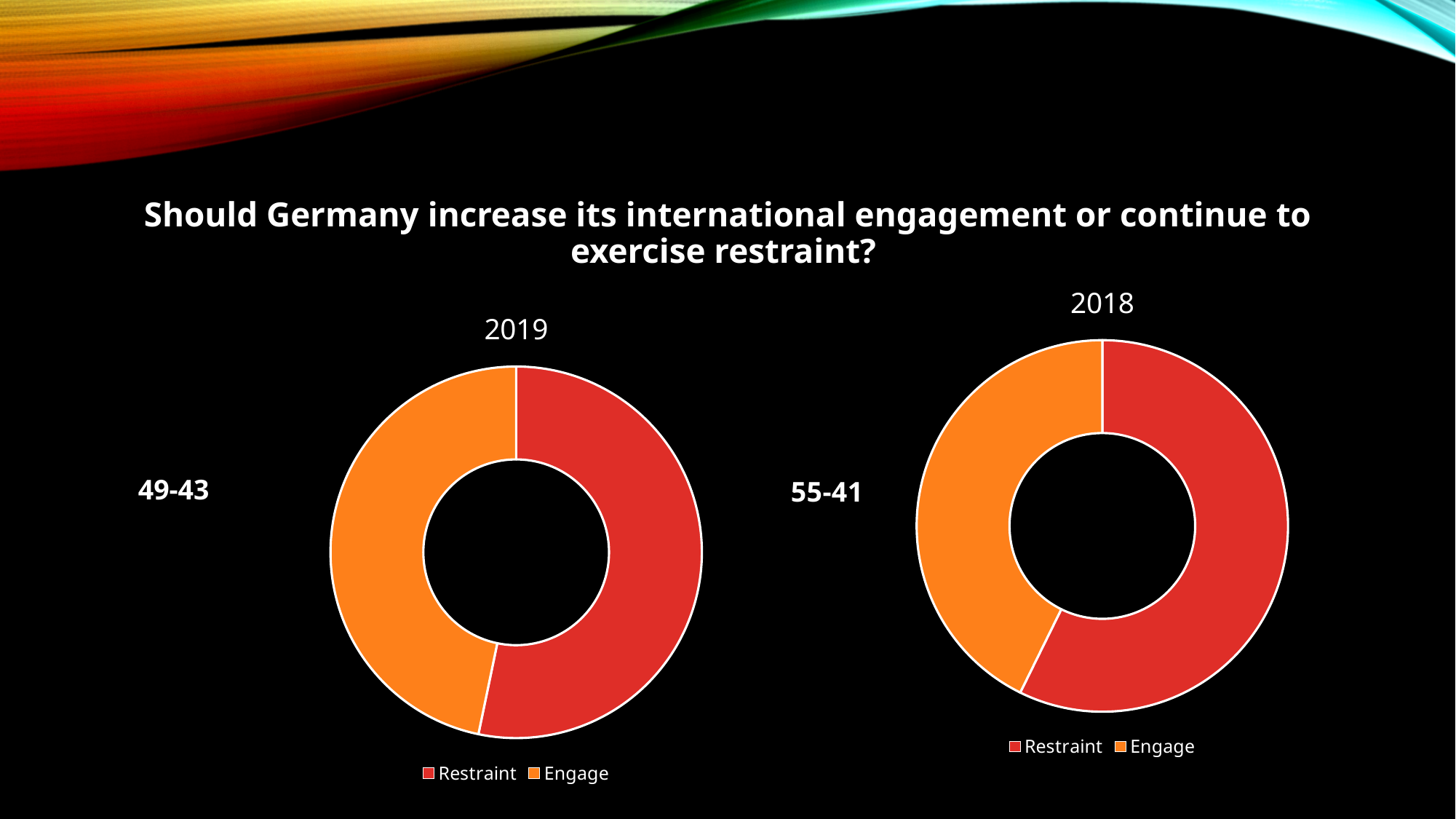
What figures are printed next to the 2019 chart? 49-43 In the 2018 chart, what value is shown for Restraint? 55 How many slices does the 2018 chart have? 2 In the 2019 chart, which category has the smallest slice? Engage In the 2019 chart, which slice is larger, Restraint or Engage? Restraint What figures are printed next to the 2018 chart? 55-41 In the 2018 chart, what is the difference between the Restraint and Engage values? 14 In the 2018 chart, which category has the largest slice? Restraint In the 2018 chart, which category has the smallest slice? Engage What kind of chart is the 2019 chart? doughnut chart How many entries does the legend of the 2019 chart list? 2 In the 2019 chart, what value is shown for Engage? 43